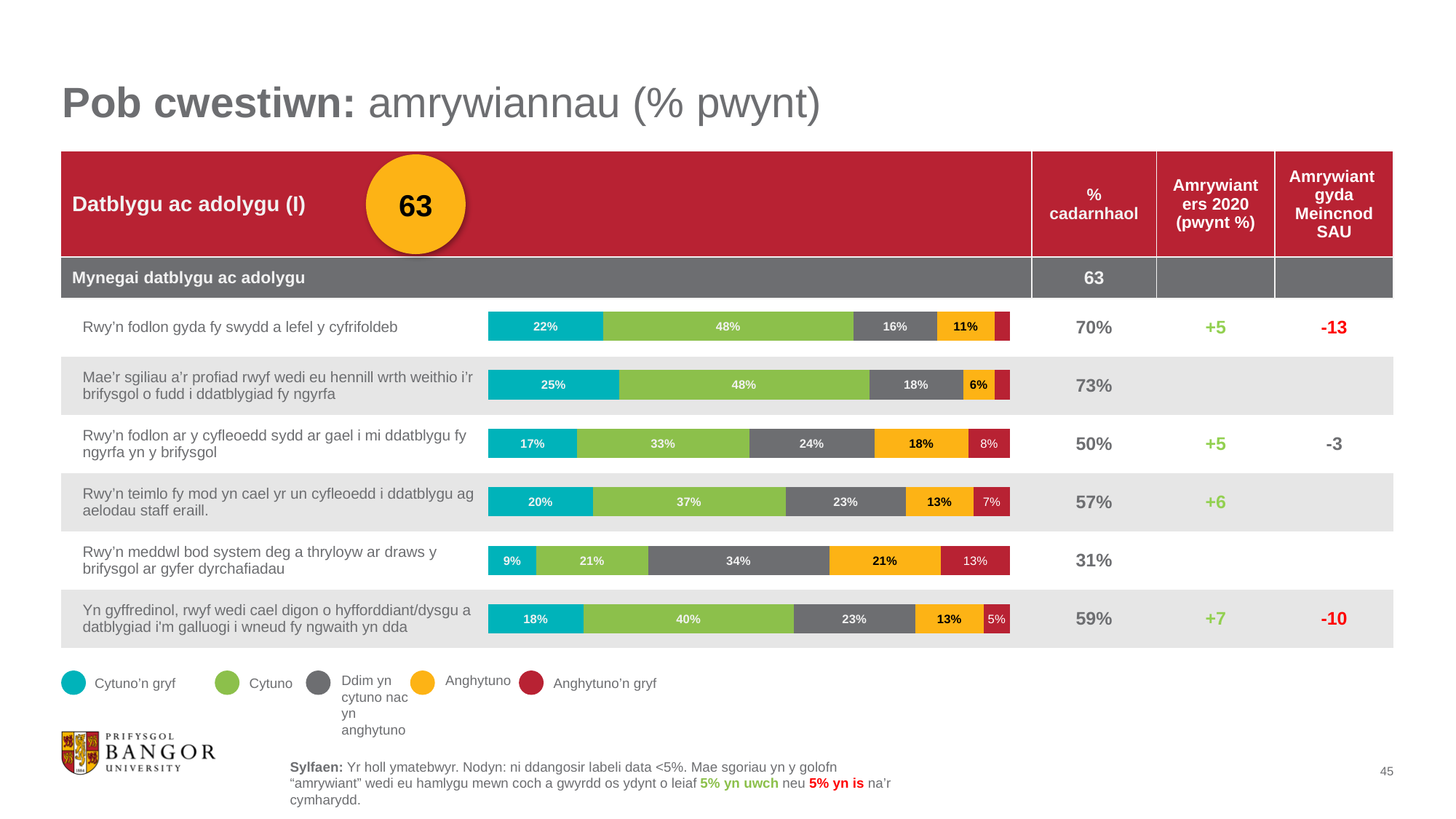
Which statement has the highest '% cadarnhaol' value? Mae'r sgiliau a'r profiad rwyf wedi eu hennill wrth weithio i'r brifysgol o fudd i ddatblygiad fy ngyrfa What is the 'Ddim yn cytuno nac yn anghytuno' value for 'Rwy'n meddwl bod system deg a thryloyw ar draws y brifysgol ar gyfer dyrchafiadau'? 34% What colour represents 'Anghytuno' in the legend? Orange/yellow How many statements are plotted in the chart? 6 What kind of chart is used to show the response breakdown for each statement? Stacked bar chart What percentage of respondents answered 'Cytuno'n gryf' for 'Rwy'n fodlon gyda fy swydd a lefel y cyfrifoldeb'? 22% What is the difference between the 'Cytuno' values for 'Yn gyffredinol, rwyf wedi cael digon o hyfforddiant/dysgu...' and 'Rwy'n teimlo fy mod yn cael yr un cyfleoedd i ddatblygu ag aelodau staff eraill'? 3% Which statement has the lowest 'Cytuno'n gryf' value? Rwy'n meddwl bod system deg a thryloyw ar draws y brifysgol ar gyfer dyrchafiadau What is the 'Anghytuno'n gryf' value for 'Rwy'n fodlon ar y cyfleoedd sydd ar gael i mi ddatblygu fy ngyrfa yn y brifysgol'? 8% What is the combined 'Cytuno'n gryf' and 'Cytuno' total for 'Rwy'n meddwl bod system deg a thryloyw ar draws y brifysgol ar gyfer dyrchafiadau'? 30% How many response categories does the legend list? 5 Which is larger: the 'Anghytuno' value for 'Rwy'n fodlon ar y cyfleoedd sydd ar gael i mi ddatblygu fy ngyrfa yn y brifysgol' or for 'Rwy'n fodlon gyda fy swydd a lefel y cyfrifoldeb'? Rwy'n fodlon ar y cyfleoedd sydd ar gael i mi ddatblygu fy ngyrfa yn y brifysgol